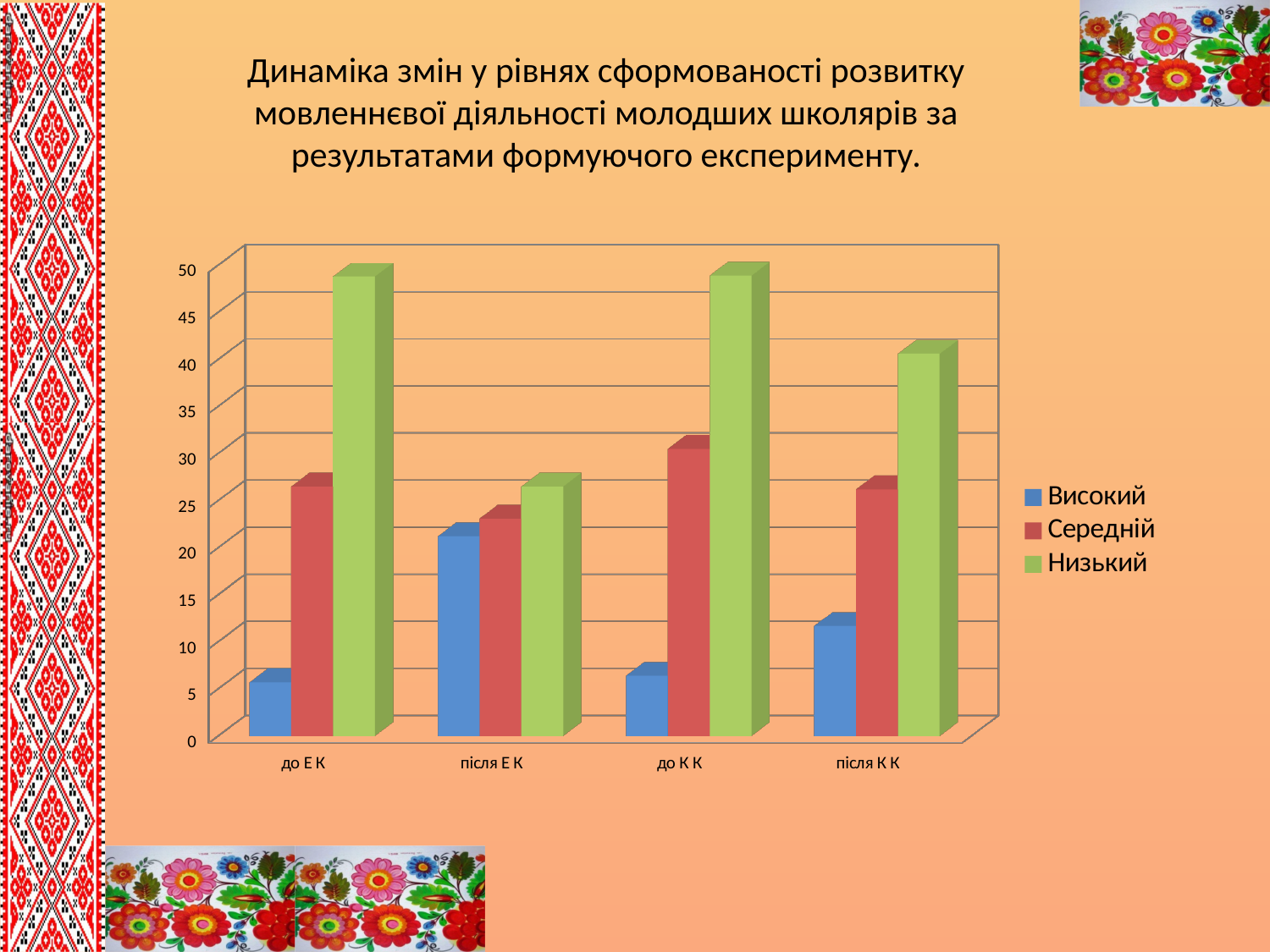
How many series does the chart legend list? 3 Is the value for 'Середній' in 'до К К' greater or less than 25? greater Which series has the lowest value in the category 'до К К'? Високий Is the value for 'Високий' in 'після Е К' greater or less than 15? greater Which series has the highest value in the category 'до Е К'? Низький How many categories are shown on the x axis of the chart? 4 What kind of chart is shown on the slide? bar chart Is the value for 'Високий' in 'до Е К' greater or less than 10? less Which series has the lowest value in the category 'до Е К'? Високий Which is larger: the value for 'Низький' in 'до К К' or in 'після К К'? до К К Which colour represents the series 'Низький' in the chart? green